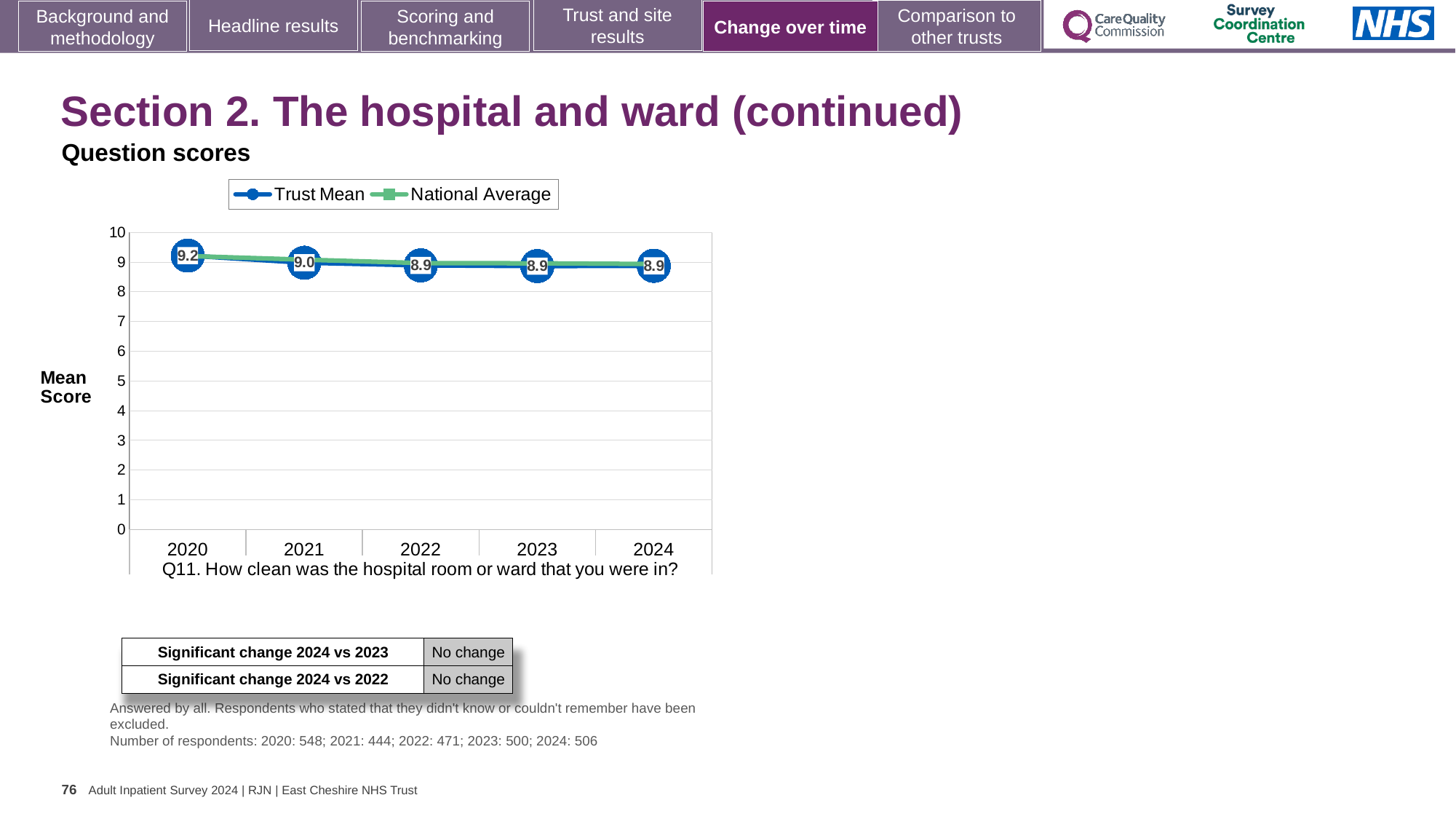
Which year has the larger Trust Mean score, 2020 or 2021? 2020 Does the Trust Mean score rise or fall from 2020 to 2024? Fall What is the difference between the Trust Mean score in 2020 and in 2024? 0.3 How many years are plotted on the x axis of the chart? 5 What kind of chart is shown on the slide? Line chart What is the Trust Mean score for 2024 for Q11? 8.9 What is the label on the y axis of the chart? Mean Score How many series does the chart legend list? 2 Is the National Average value for 2022 greater or less than 5? greater In which year was the Trust Mean score for Q11 highest? 2020 What is the Trust Mean score for 2020 for Q11? 9.2 What is the Trust Mean score for 2021 for Q11? 9.0